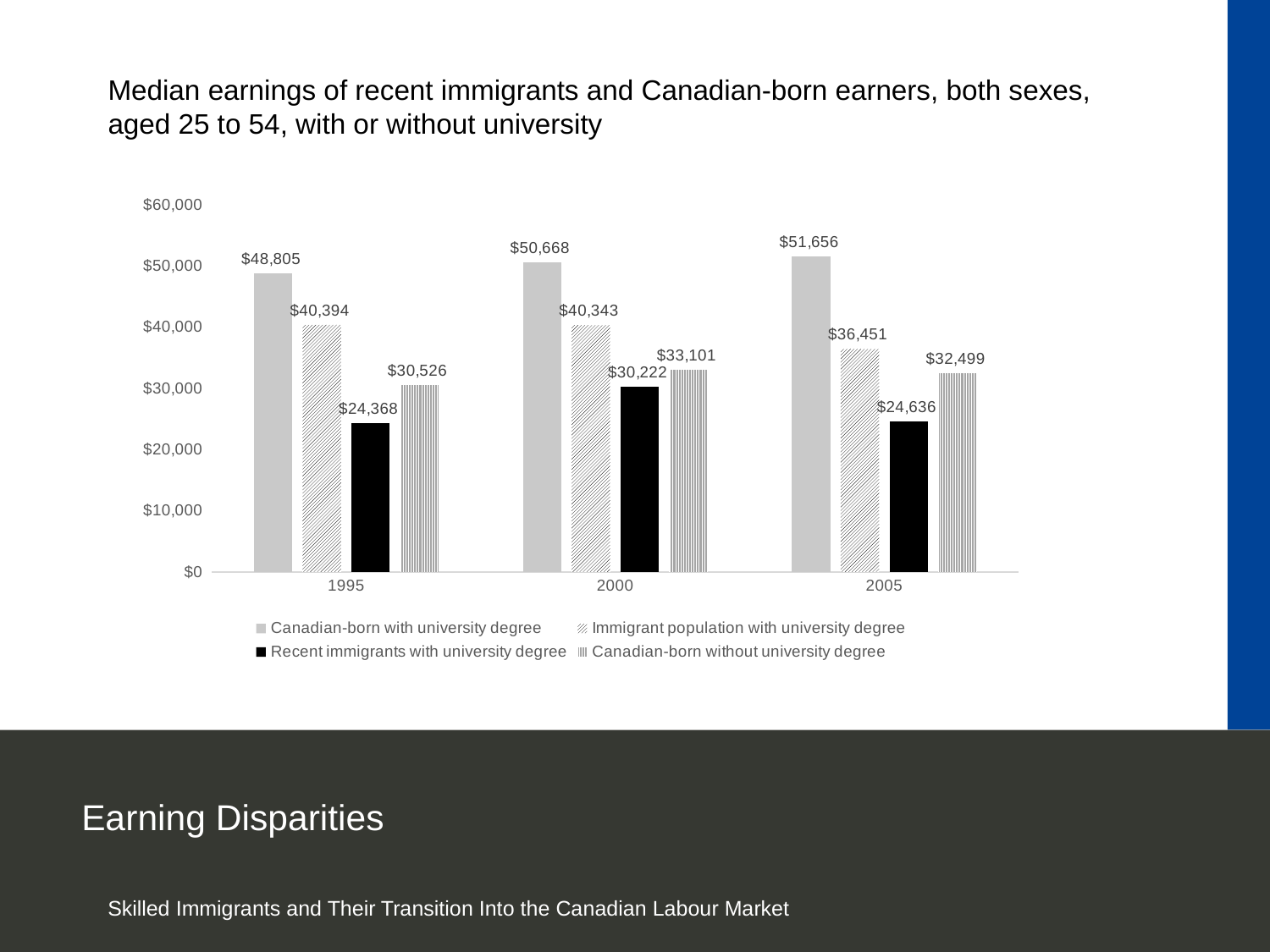
Which is larger in 1995: the median earnings of recent immigrants with a university degree or Canadian-born earners without a university degree? Canadian-born without university degree What is the median earnings of Canadian-born earners with a university degree in 1995? $48,805 How many years are shown on the x axis of the chart? 3 Do the median earnings of Canadian-born earners with a university degree rise or fall from 1995 to 2005? Rise How many series does the chart's legend list? 4 What is the median earnings of the immigrant population with a university degree in 2005? $36,451 In which year is the median earnings of Canadian-born earners with a university degree highest? 2005 What is the median earnings of Canadian-born earners without a university degree in 2000? $33,101 What kind of chart is shown on the slide? Bar chart Which series has the lowest median earnings in 2005? Recent immigrants with university degree What is the median earnings of recent immigrants with a university degree in 2000? $30,222 What is the difference between the median earnings of Canadian-born earners with a university degree and recent immigrants with a university degree in 2005? $27,020